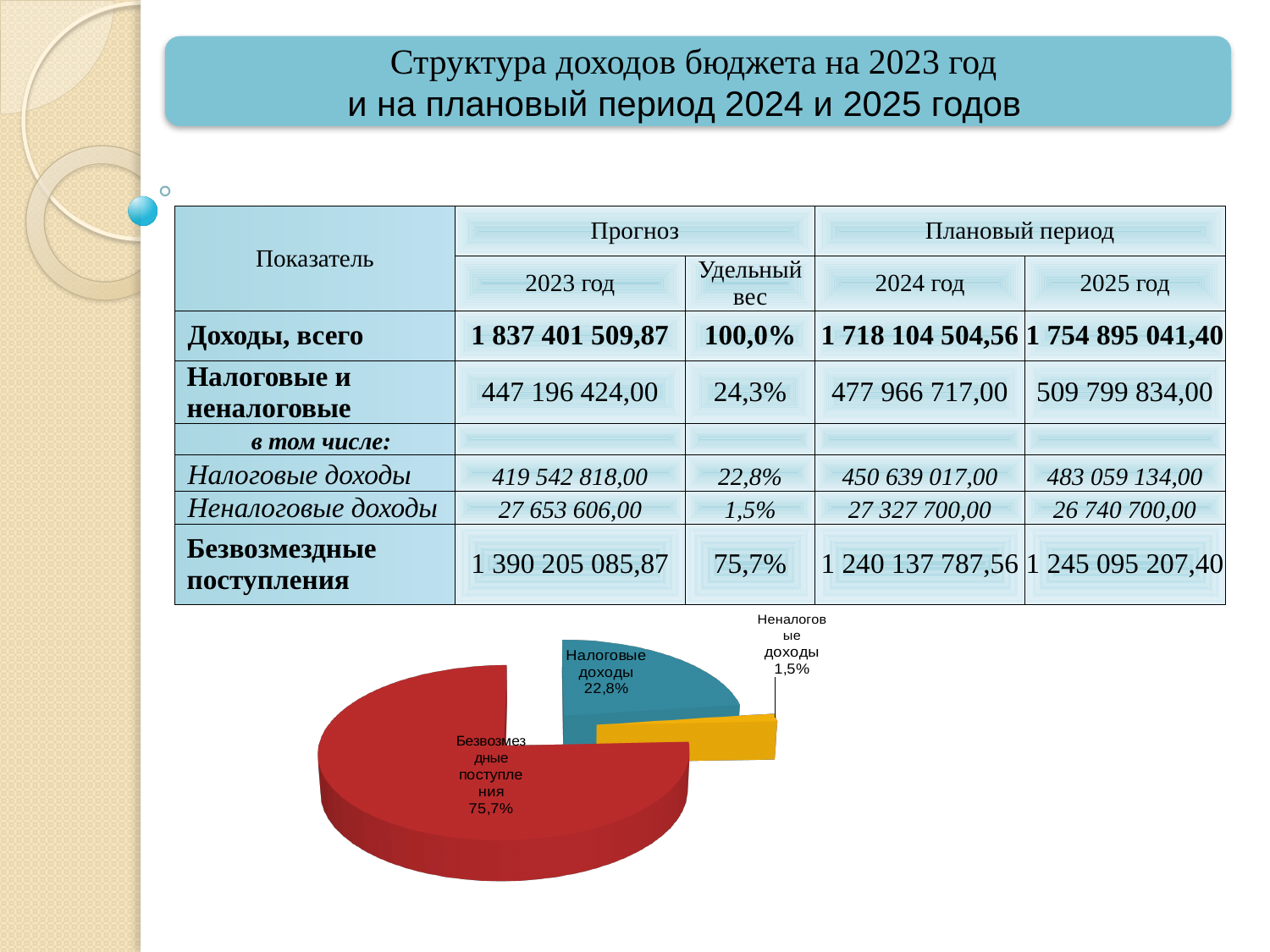
Which slice of the pie chart is the largest? Безвозмездные поступления Which slice of the pie chart is the smallest? Неналоговые доходы What colour is the Неналоговые доходы slice in the pie chart? yellow How many slices does the pie chart have? 3 Which is larger in the pie chart, Налоговые доходы or Неналоговые доходы? Налоговые доходы What is the difference in percentage points between the Налоговые доходы slice and the Неналоговые доходы slice? 21,3 What colour is the Безвозмездные поступления slice in the pie chart? red What share of the pie does Безвозмездные поступления have? 75,7% What share of the pie does Неналоговые доходы have? 1,5% What share of the pie does Налоговые доходы have? 22,8% What kind of chart is shown at the bottom of the slide? pie chart What is the difference in percentage points between the Безвозмездные поступления slice and the Налоговые доходы slice? 52,9